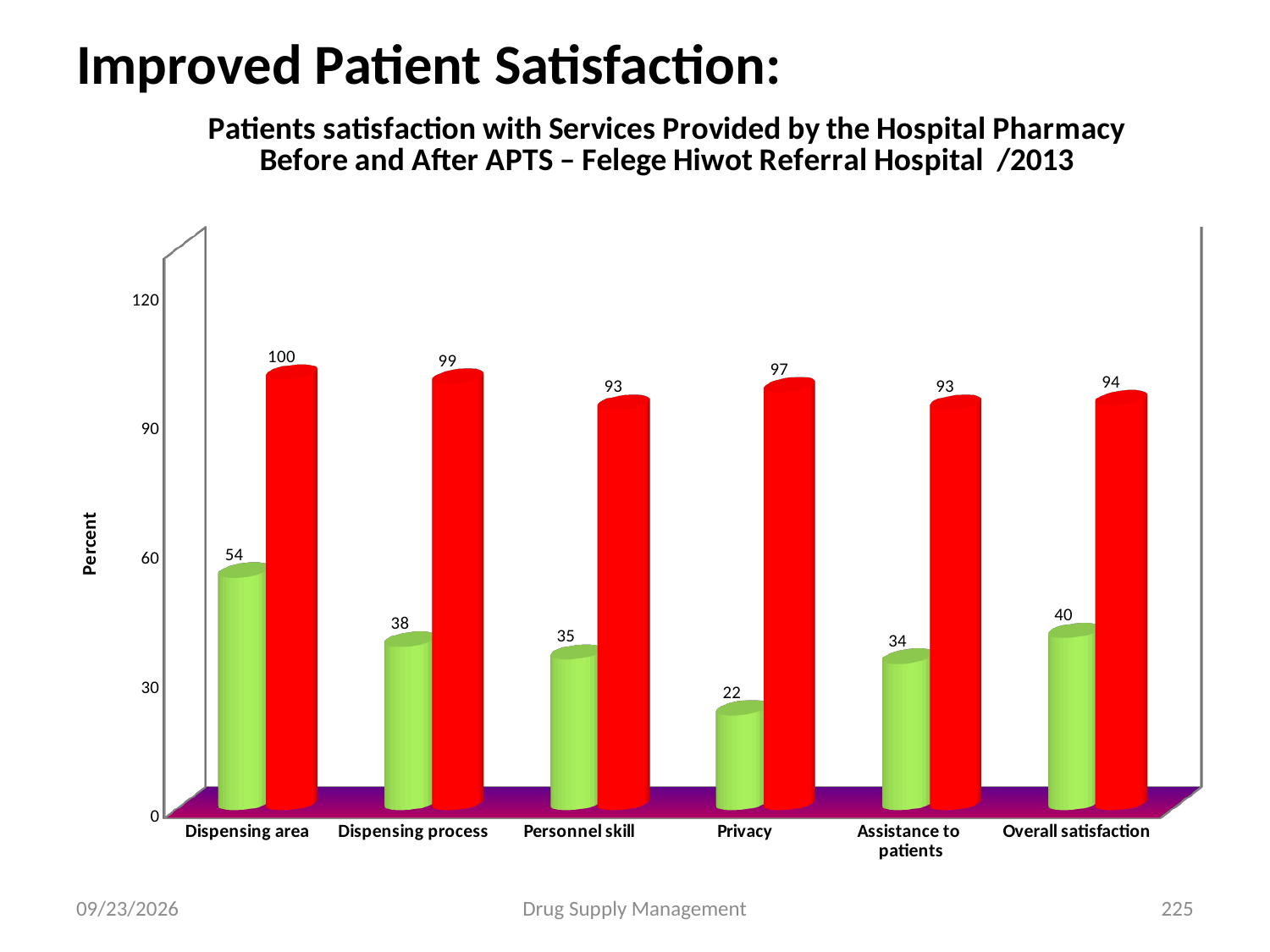
What is the value of the green bar for Overall satisfaction? 40 Which is larger, the green bar for Personnel skill or the green bar for Assistance to patients? Personnel skill What is the label on the vertical axis? Percent What is the difference between the red and green bars for Privacy? 75 What type of chart is shown? bar chart What is the value of the red bar for Privacy? 97 What is the value of the green bar for Dispensing area? 54 Is the red bar for Overall satisfaction greater or less than 90? greater What is the difference between the green bars for Dispensing area and Dispensing process? 16 Which category has the lowest green bar? Privacy How many categories are shown on the x axis? 6 Which category has the highest red bar? Dispensing area